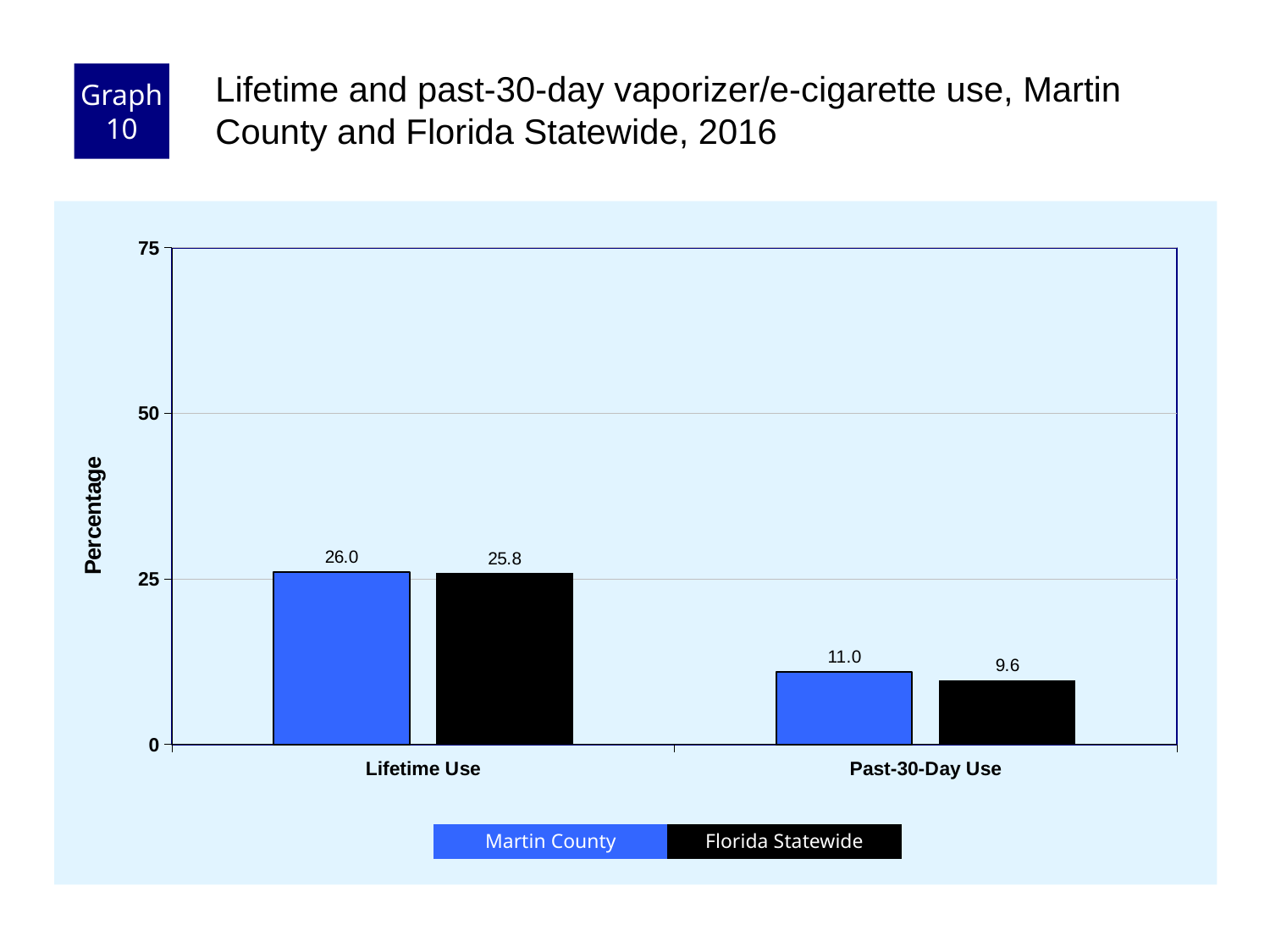
What is the Florida Statewide value for Lifetime Use? 25.8 What is the Florida Statewide value for Past-30-Day Use? 9.6 What kind of chart is shown on the slide? Bar chart How many categories are shown on the x axis? 2 Which category has the lowest Florida Statewide value? Past-30-Day Use How many series does the legend list? 2 What is the Martin County value for Past-30-Day Use? 11.0 What is the difference between the Martin County and Florida Statewide values for Past-30-Day Use? 1.4 What is the Martin County value for Lifetime Use? 26.0 Which category has the highest Martin County value? Lifetime Use What is the difference between the Martin County values for Lifetime Use and Past-30-Day Use? 15.0 Which is larger: the Martin County value for Lifetime Use or the Martin County value for Past-30-Day Use? Lifetime Use